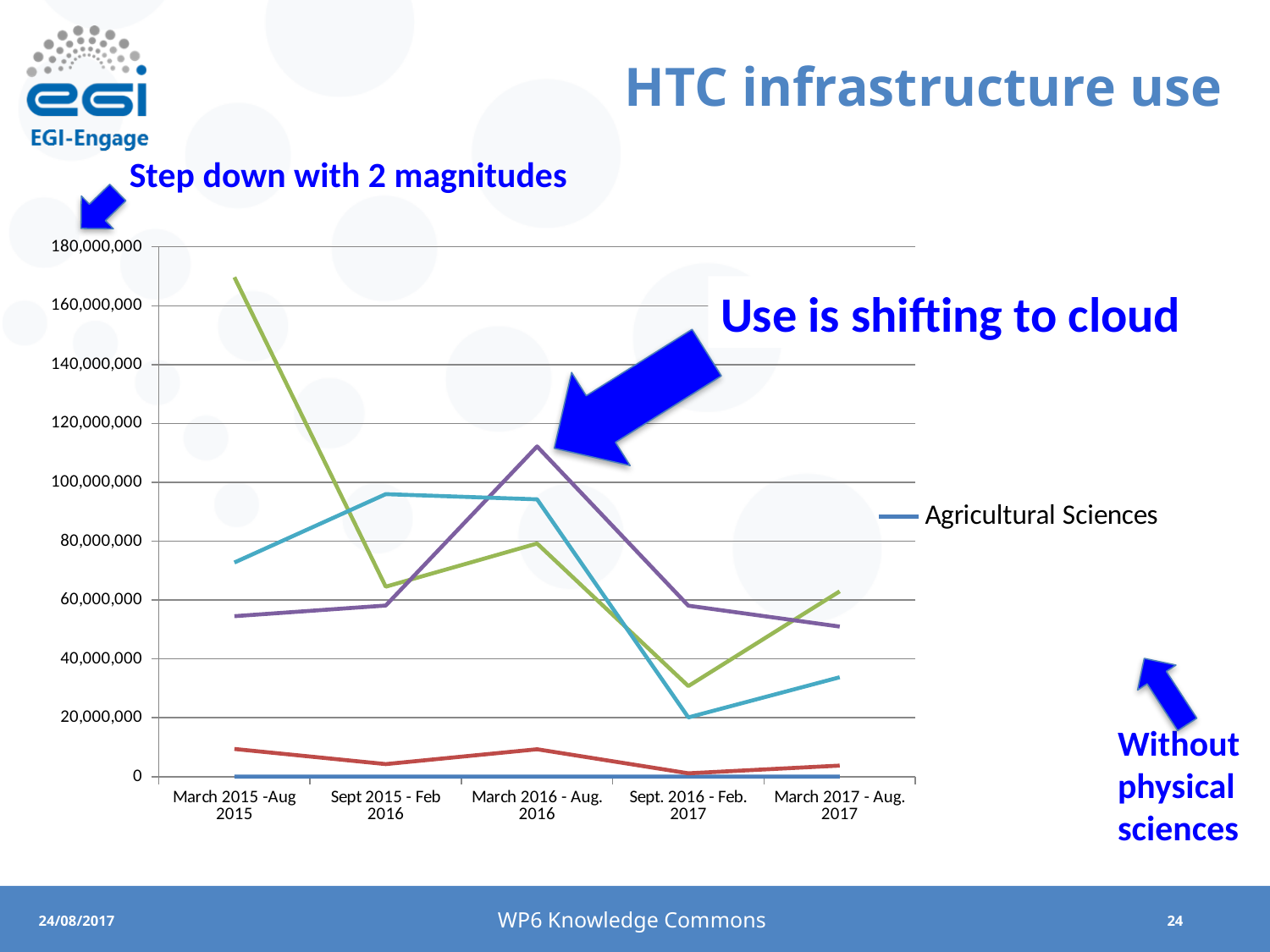
Which series name appears in the chart's legend? Agricultural Sciences In which period does the highest value plotted on the chart occur? March 2015 -Aug 2015 Is the highest value plotted on the chart greater or less than 160,000,000? greater What is the highest value shown on the chart's y axis? 180,000,000 What kind of chart is shown on the slide? line chart How many series does the visible legend of the chart list? 1 Is the value for Agricultural Sciences in March 2017 - Aug. 2017 greater or less than 20,000,000? less Is the value for Agricultural Sciences in March 2015 -Aug 2015 greater or less than 20,000,000? less How many time periods are shown on the x axis of the chart? 5 What is the label of the last period on the x axis? March 2017 - Aug. 2017